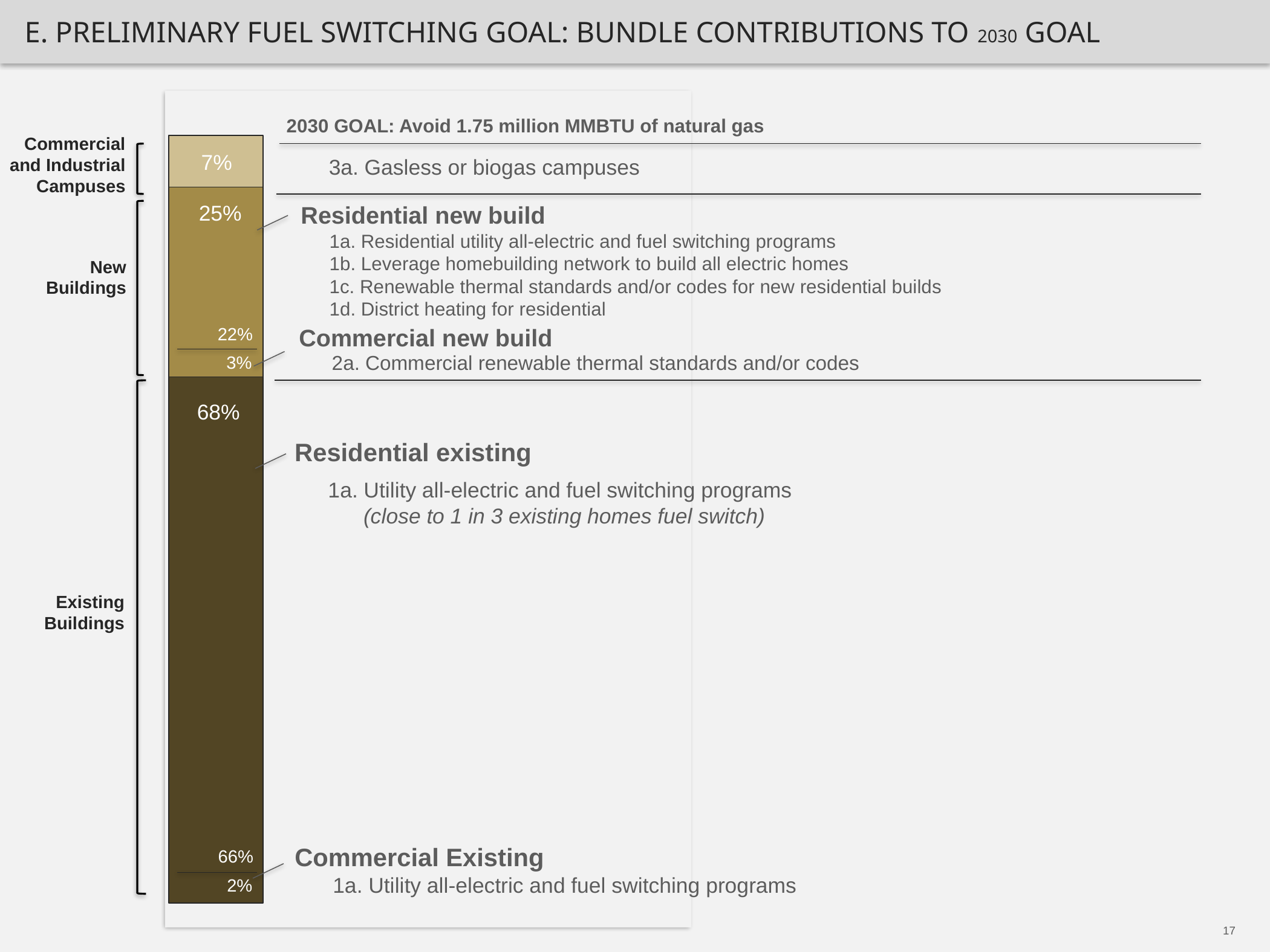
What share of the 2030 goal comes from Residential new build? 22% What share of the 2030 goal comes from Commercial and Industrial Campuses? 7% What share of the 2030 goal comes from New Buildings? 25% What share of the 2030 goal comes from Commercial Existing? 2% Which of the three building groups contributes the largest share of the 2030 goal? Existing Buildings What share of the 2030 goal comes from Existing Buildings? 68% Which contributes more to the 2030 goal, Residential new build or Commercial new build? Residential new build Which of the three building groups contributes the smallest share of the 2030 goal? Commercial and Industrial Campuses What share of the 2030 goal comes from Commercial new build? 3% What kind of chart is shown on the slide? Stacked bar chart What share of the 2030 goal comes from Residential existing? 66% What is the difference between the Existing Buildings share and the New Buildings share? 43%